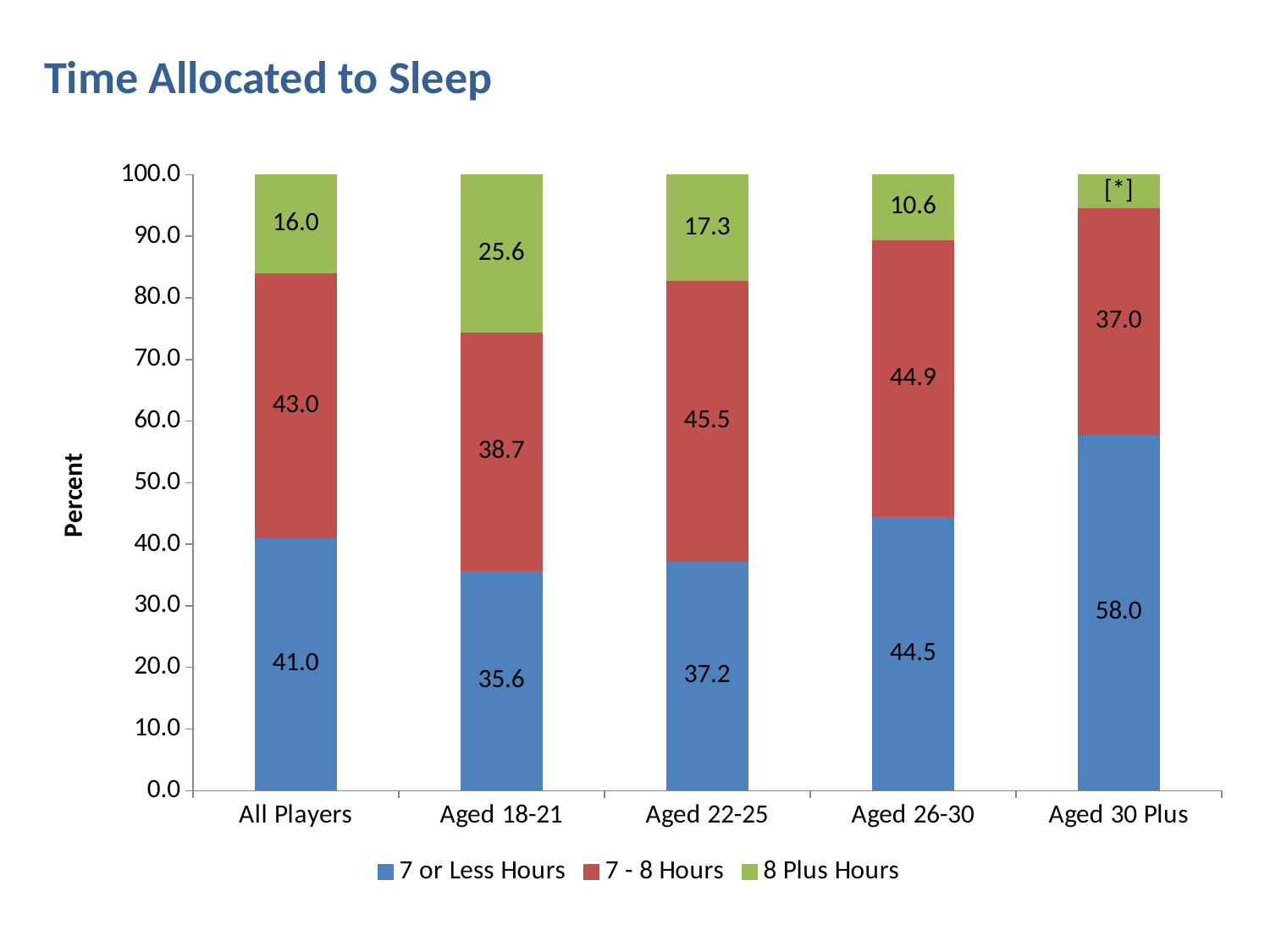
Which category has the highest value for 8 Plus Hours? Aged 18-21 How many series does the legend list? 3 What is the value for 7 - 8 Hours for All Players? 43.0 What is the value for 7 - 8 Hours for Aged 22-25? 45.5 Which is larger, the 7 - 8 Hours value for Aged 26-30 or for Aged 30 Plus? Aged 26-30 Which category has the highest value for 7 or Less Hours? Aged 30 Plus What is the value for 7 or Less Hours for Aged 30 Plus? 58.0 What is the value for 8 Plus Hours for Aged 18-21? 25.6 What kind of chart is shown on the slide? Stacked bar chart Which category has the lowest value for 7 or Less Hours? Aged 18-21 How many categories are shown on the x axis? 5 What is the difference between the 7 or Less Hours values for Aged 30 Plus and Aged 18-21? 22.4